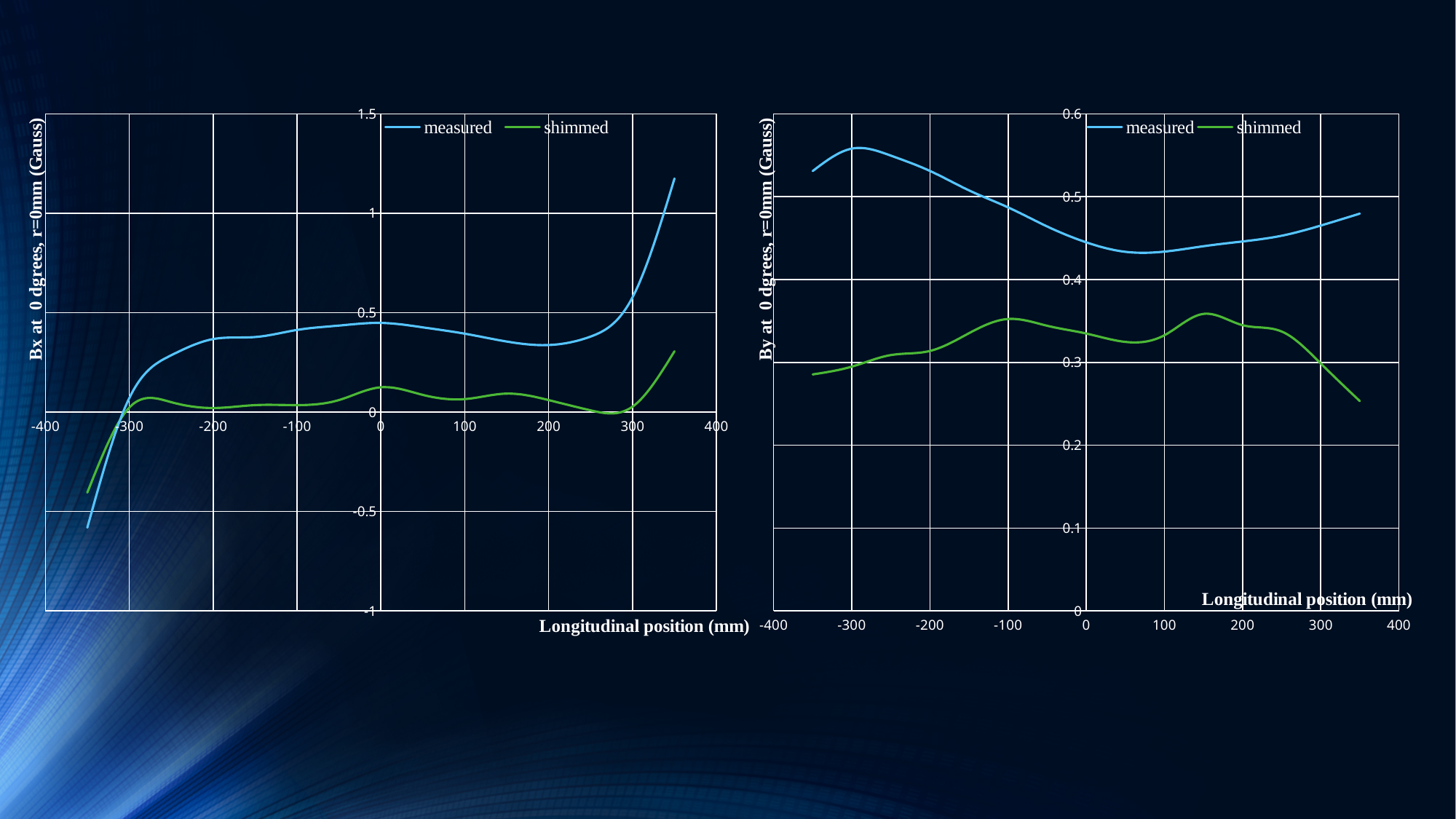
In the right chart (By at 0 degrees, r=0mm), does the measured series rise or fall between -300 mm and 100 mm? fall In the left chart (Bx at 0 degrees, r=0mm), is the measured value at -350 mm greater or less than 0? less What type of chart is the left chart (Bx at 0 degrees, r=0mm)? line chart In the right chart (By at 0 degrees, r=0mm), which series has the larger value at 0 mm, measured or shimmed? measured In the left chart (Bx at 0 degrees, r=0mm), does the measured series rise or fall between 200 mm and 350 mm? rise What is the x-axis title of the right chart (By at 0 degrees, r=0mm)? Longitudinal position (mm) In the right chart (By at 0 degrees, r=0mm), is the measured value at -300 mm greater or less than 0.5? greater How many series does the legend of the right chart (By at 0 degrees, r=0mm) list? 2 What are the two series named in the legend of the left chart? measured, shimmed In the left chart (Bx at 0 degrees, r=0mm), is the shimmed value at 0 mm greater or less than 0.5? less